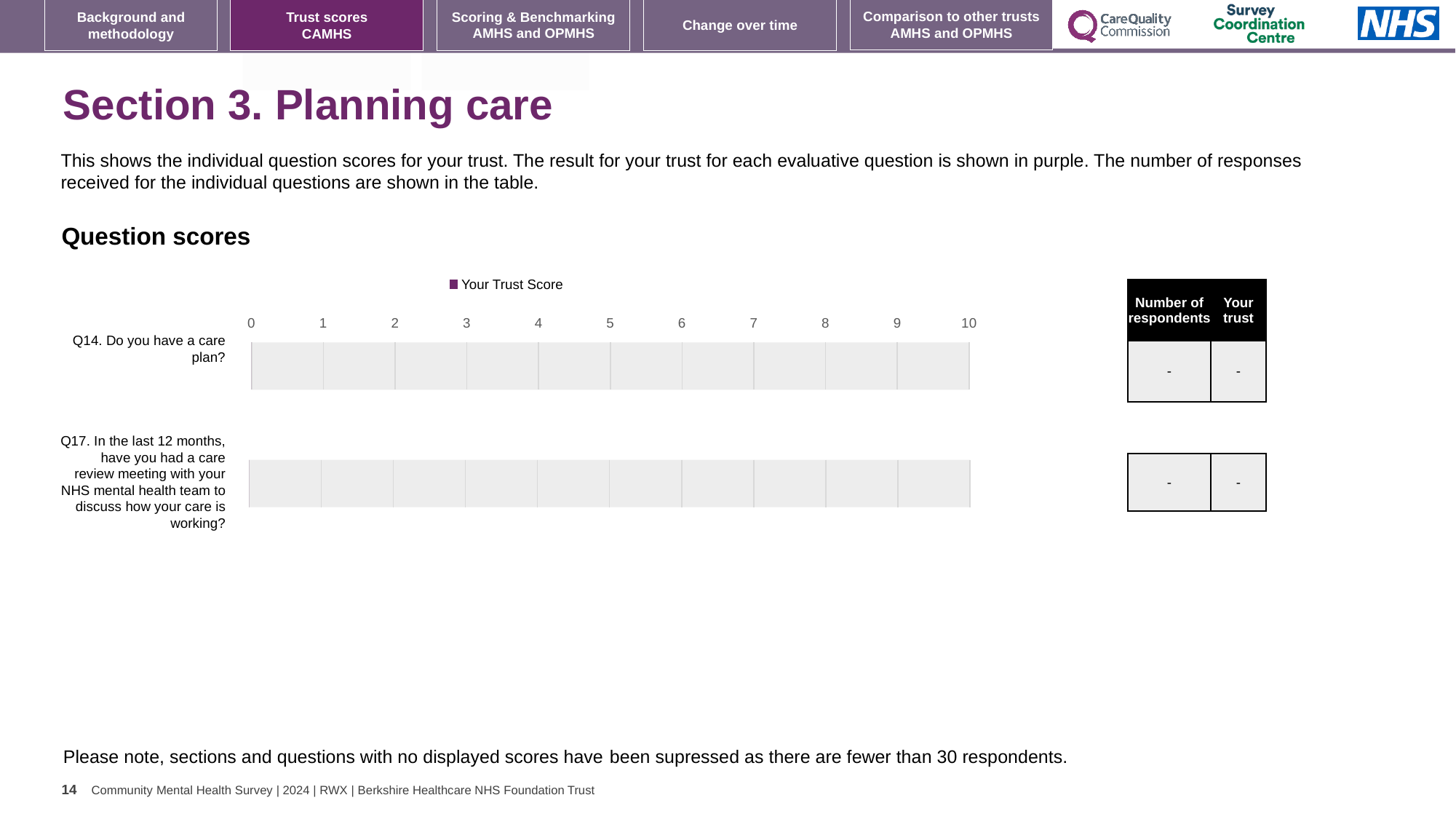
How many questions (categories) are listed on the chart's vertical axis? 2 How many series does the chart legend list? 1 What kind of chart is shown under "Question scores"? bar chart What is shown in the "Your trust" column of the table for Q14? - What is shown in the "Number of respondents" column of the table for Q17? - What is the highest value shown on the chart's horizontal axis? 10 What is the name of the series shown in the chart legend? Your Trust Score